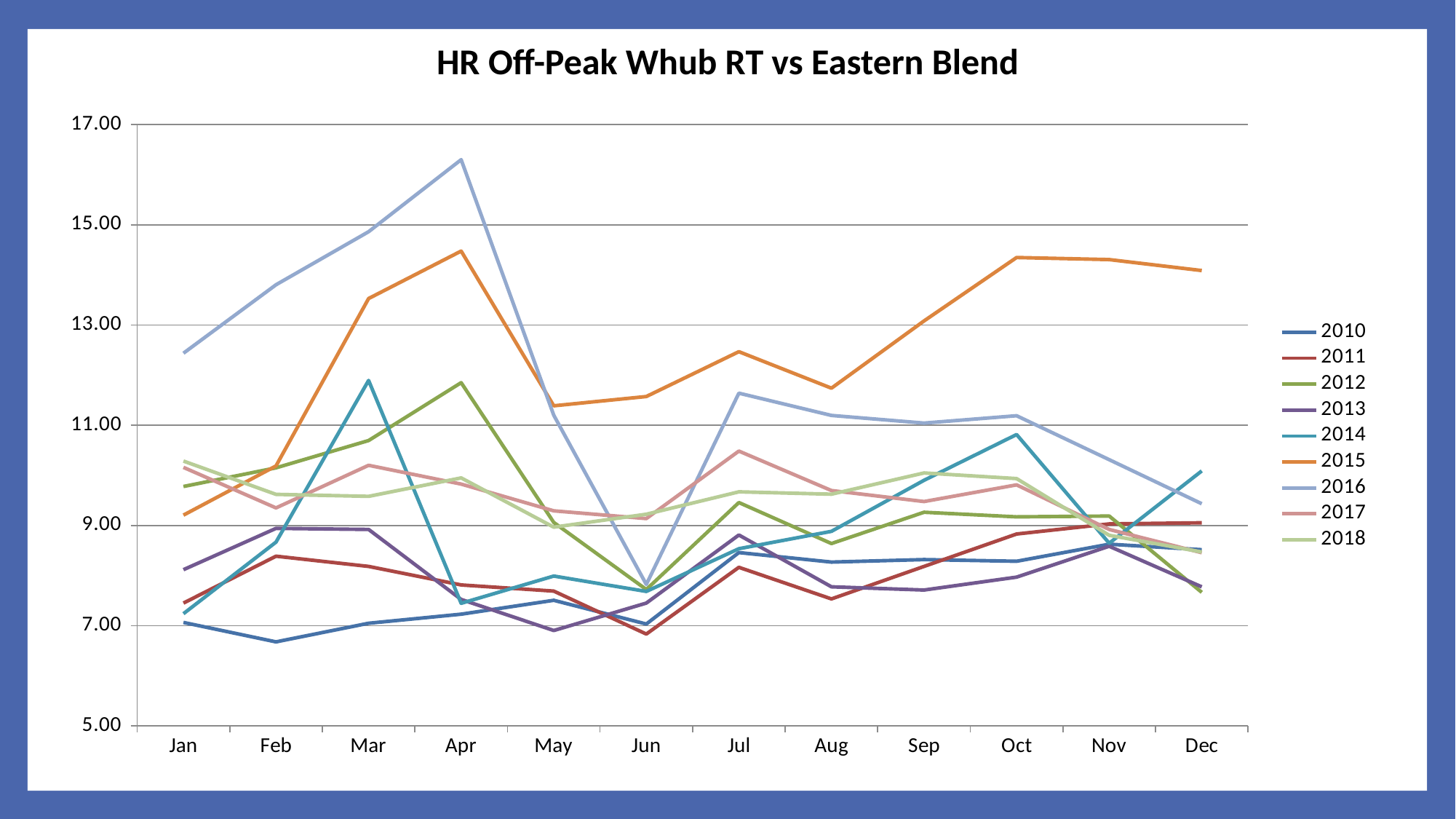
Is the value for 2014 in Mar greater or less than 11.00? greater In Dec, which is larger: the value for 2015 or the value for 2016? 2015 Is the value for 2016 in Apr greater or less than 15.00? greater What kind of chart is shown on the slide? line chart Which series has the highest value in Apr? 2016 Which series has the lowest value in Feb? 2010 Does the 2016 series rise or fall from Apr to Jun? fall Is the value for 2010 in Feb greater or less than 7.00? less What is the title of the chart? HR Off-Peak Whub RT vs Eastern Blend How many series does the legend list? 9 How many months are shown along the x axis? 12